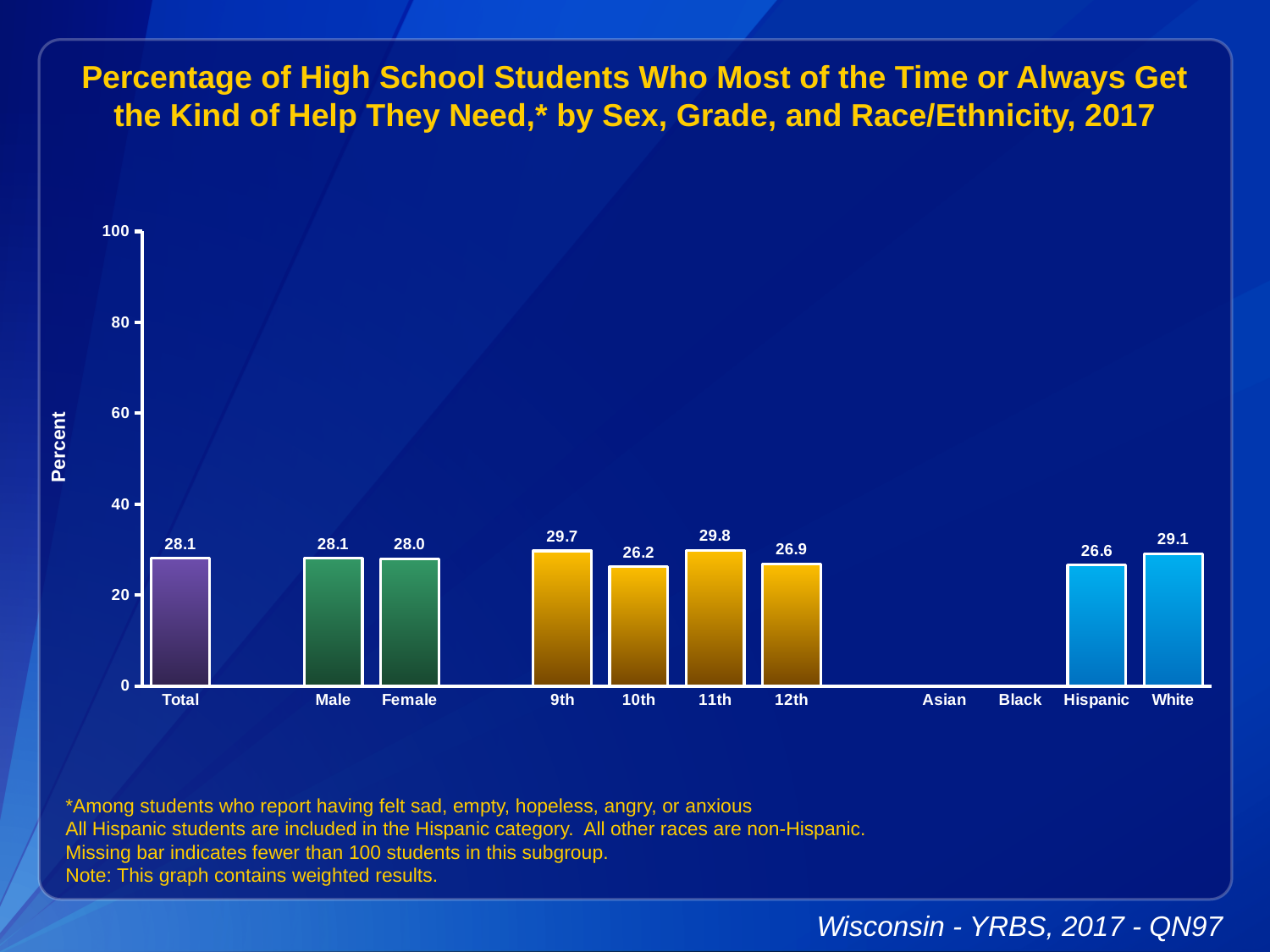
What is the value for Total? 28.1 Which race/ethnicity category shown has the highest value? White What is the value for 11th grade students? 29.8 What is the difference between the values for 9th and 10th grade? 3.5 Is the value for Total greater or less than 40? less What kind of chart is shown on the slide? bar chart What is the label on the y axis? Percent What is the value for Hispanic students? 26.6 Which categories on the x axis have no bar plotted? Asian and Black Which is larger, the value for Male or the value for Female? Male How many bars are plotted on the chart? 9 Which category has the lowest value on the chart? 10th